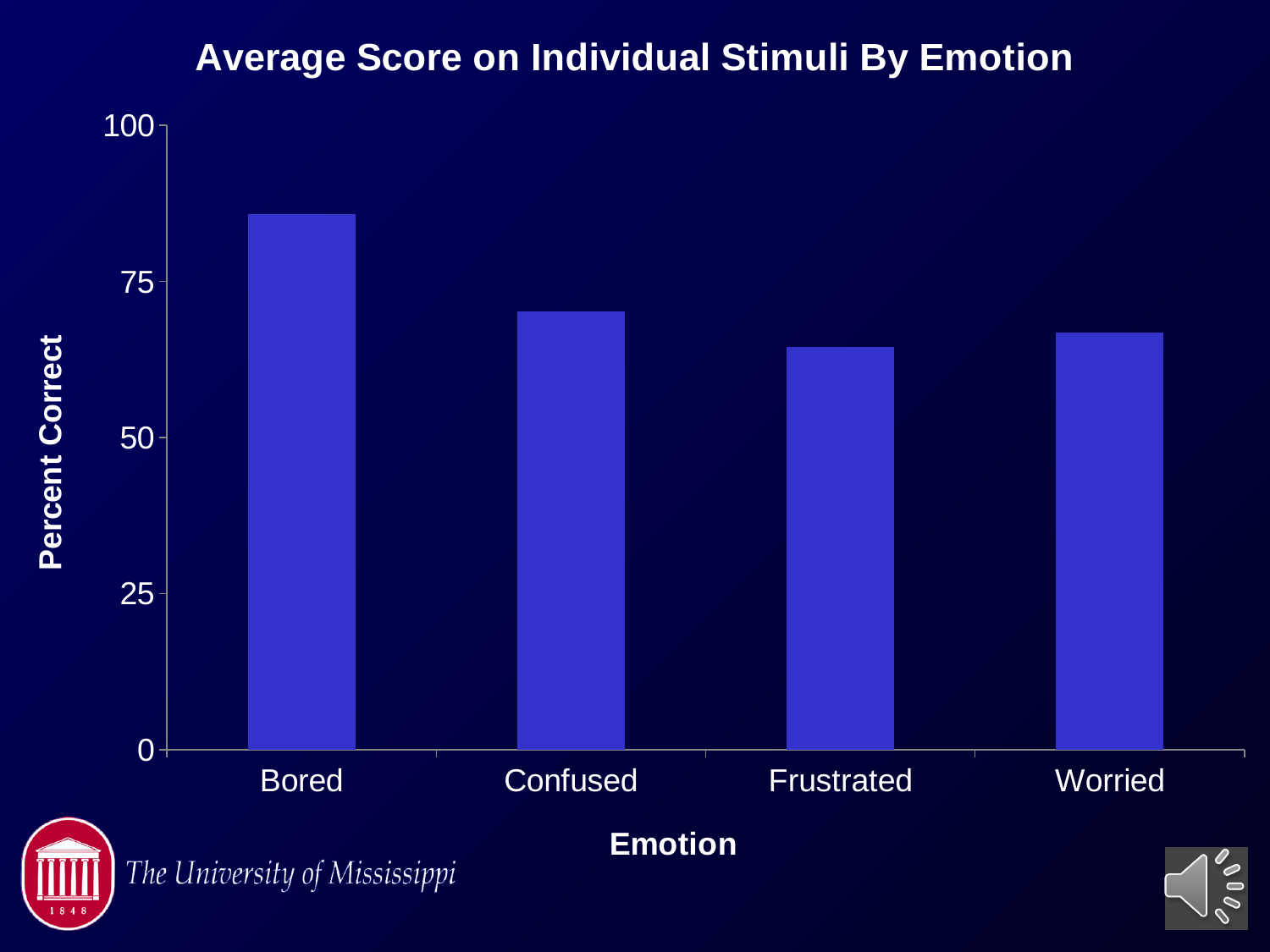
Which has a higher percent correct, Bored or Worried? Bored Which has a higher percent correct, Bored or Confused? Bored Which has a higher percent correct, Confused or Frustrated? Confused Is the value for Confused greater or less than 75? less Is the value for Bored greater or less than 75? greater How many emotion categories are plotted on the chart? 4 What is the label on the vertical axis of the chart? Percent Correct Is the value for Frustrated greater or less than 50? greater What kind of chart is shown on the slide? Bar chart What is the title of the chart? Average Score on Individual Stimuli By Emotion Which emotion has the highest percent correct? Bored